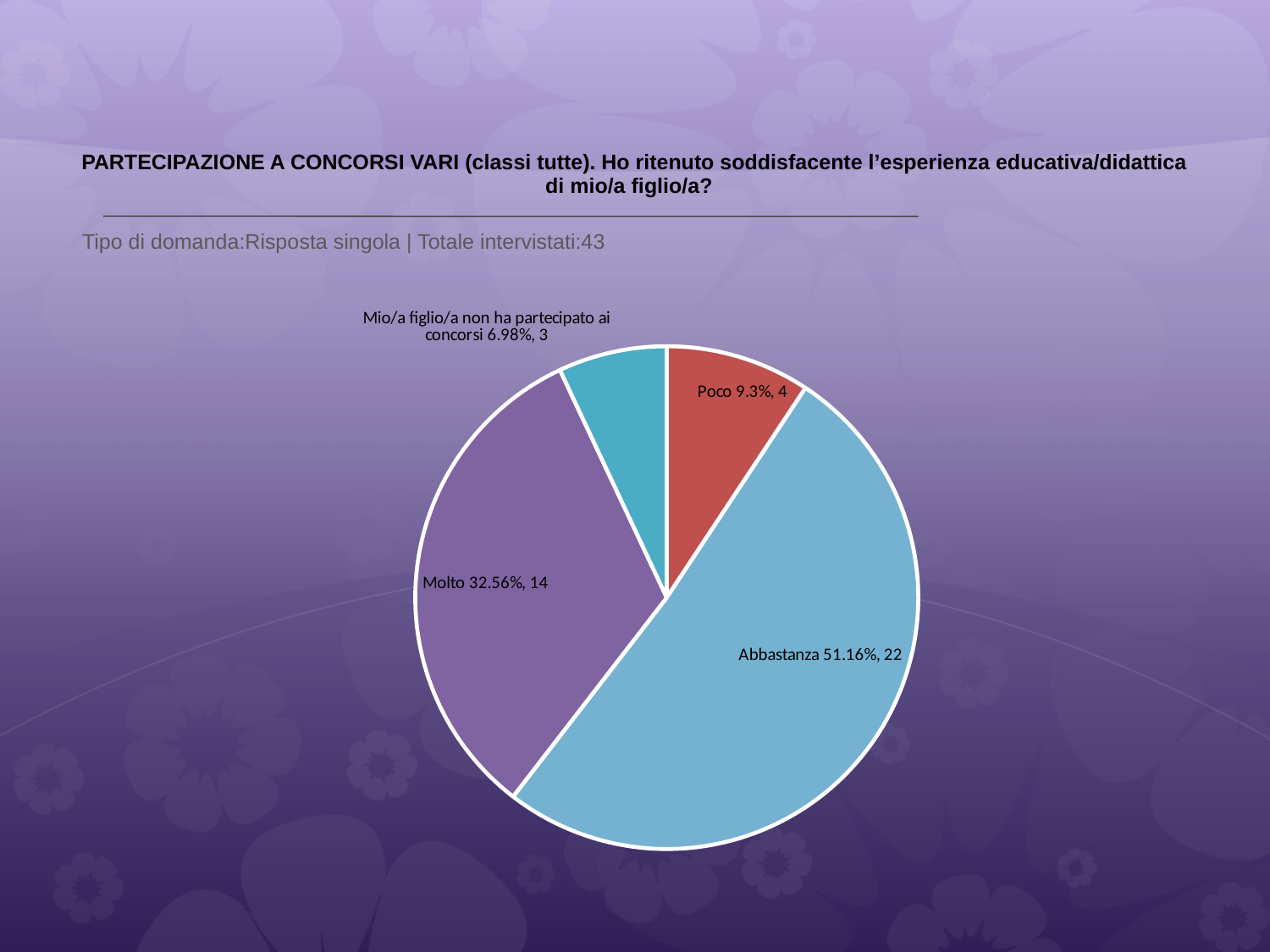
What colour is the 'Molto' slice? purple What kind of chart is shown on the slide? pie chart How many respondents answered 'Molto'? 14 What percentage share does the 'Mio/a figlio/a non ha partecipato ai concorsi' slice have? 6.98% What is the total number of respondents shown on the slide? 43 How many respondents answered 'Poco'? 4 Which category has the smallest slice? Mio/a figlio/a non ha partecipato ai concorsi What percentage share does the 'Abbastanza' slice have? 51.16% Which has more respondents, 'Poco' or 'Molto'? Molto What is the difference in respondent count between 'Abbastanza' and 'Molto'? 8 Which category has the largest slice? Abbastanza How many slices does the pie chart have? 4